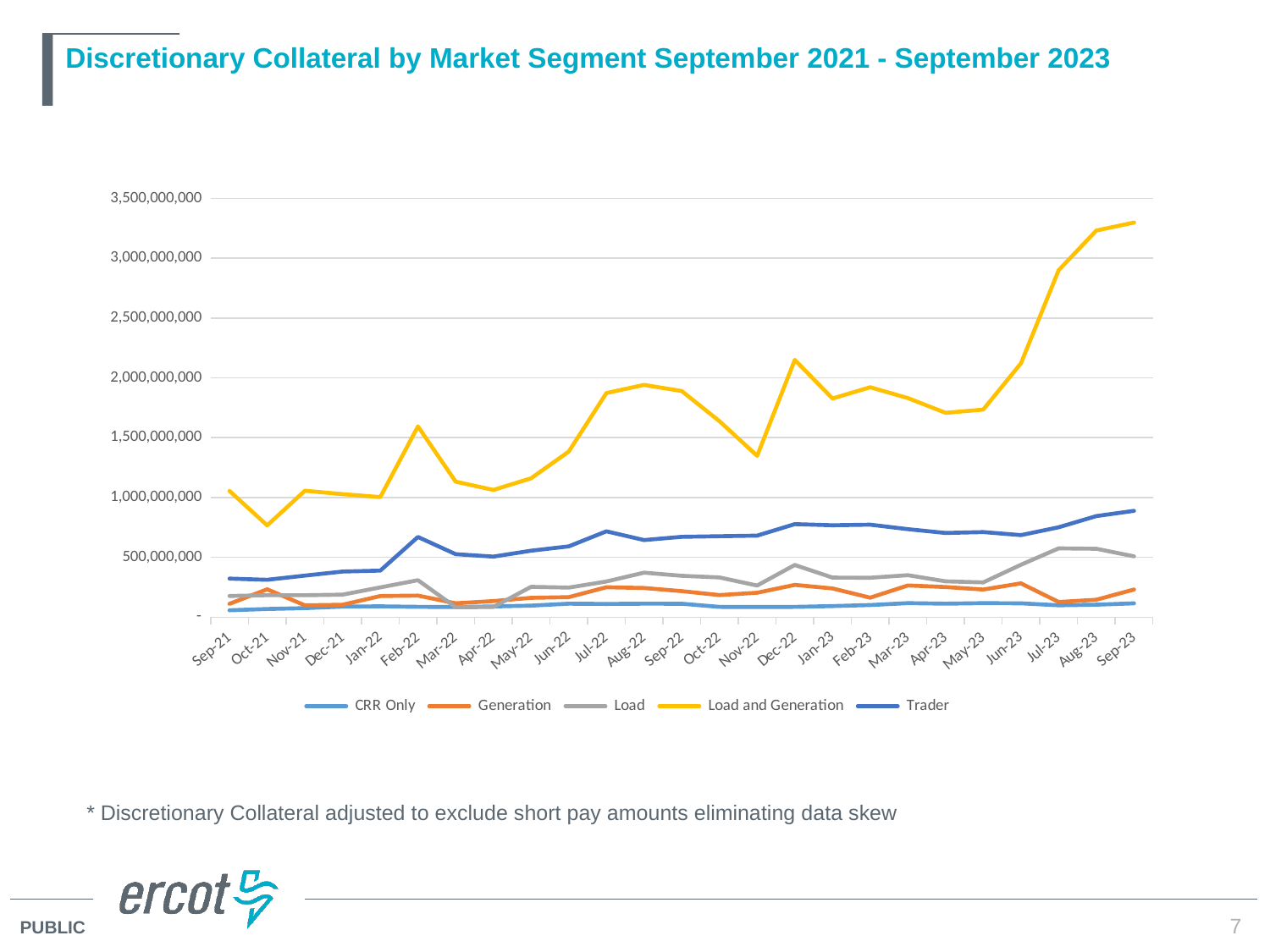
Is the value for Load and Generation in Oct-21 greater or less than 1,000,000,000? less What is the title of the chart? Discretionary Collateral by Market Segment September 2021 - September 2023 How many months are plotted along the x axis? 25 Is the value for Trader in Feb-22 greater or less than 500,000,000? greater How many series does the legend list? 5 In Sep-23, which is larger, the value for Trader or the value for Load? Trader Which market segment has the highest discretionary collateral in Sep-23? Load and Generation Does the Load and Generation line rise or fall from May-23 to Sep-23? Rise Is the value for Load and Generation in Sep-23 greater or less than 3,000,000,000? greater Which market segment has the lowest discretionary collateral in Sep-23? CRR Only What kind of chart is shown on the slide? Line chart